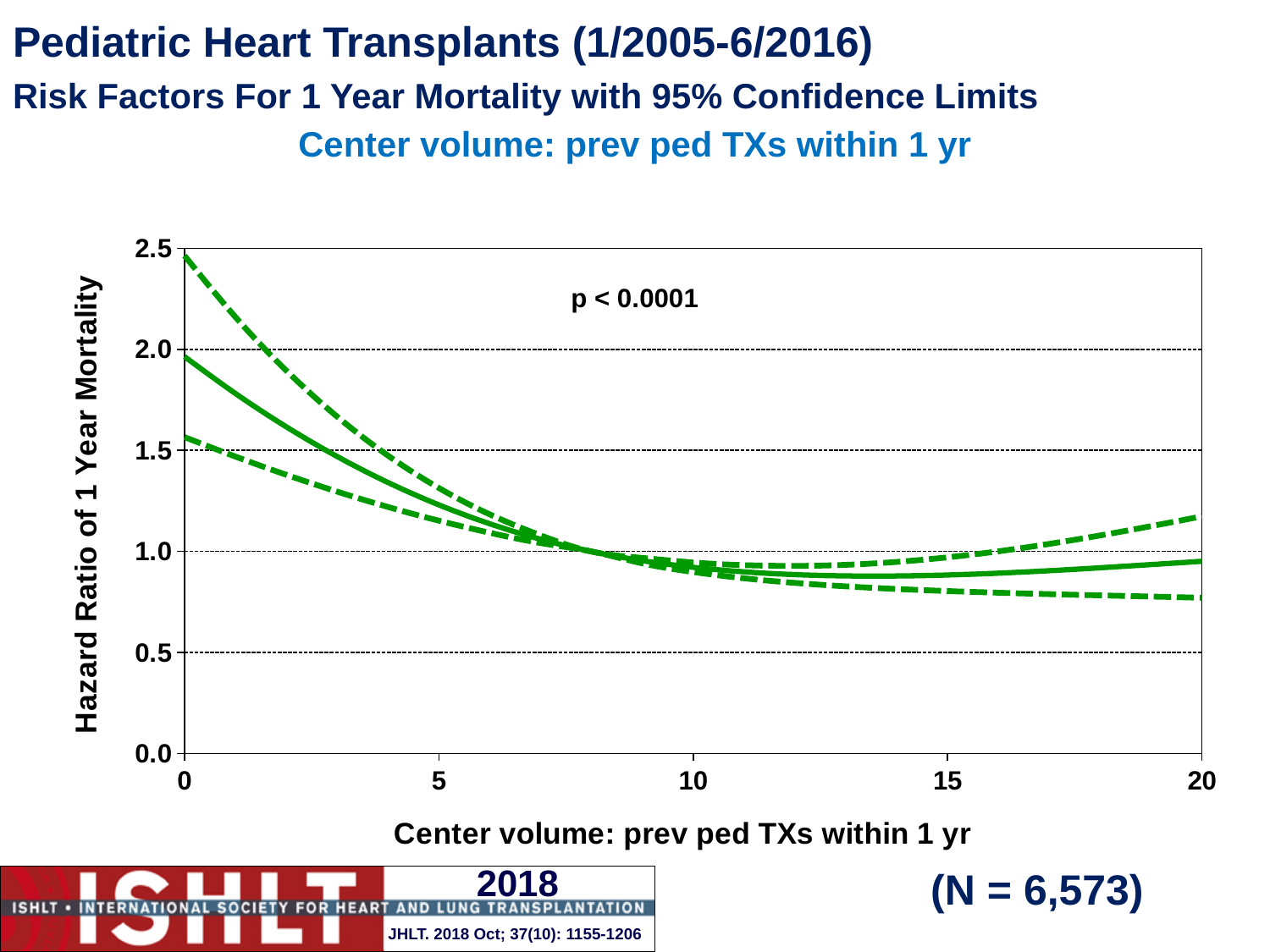
Does the solid hazard ratio line rise or fall as center volume increases from 0 to 10? fall Is the solid hazard ratio line at a center volume of 15 greater or less than 1.0? less Is the lower dashed confidence limit at a center volume of 20 greater or less than 1.0? less Is the upper dashed confidence limit at a center volume of 0 greater or less than 2.0? greater How many lines are plotted on the chart? 3 What kind of chart is shown on the slide? line chart What is the maximum value shown on the y axis? 2.5 What p-value is printed on the chart? p < 0.0001 Is the hazard ratio higher at a center volume of 0 or at a center volume of 10? 0